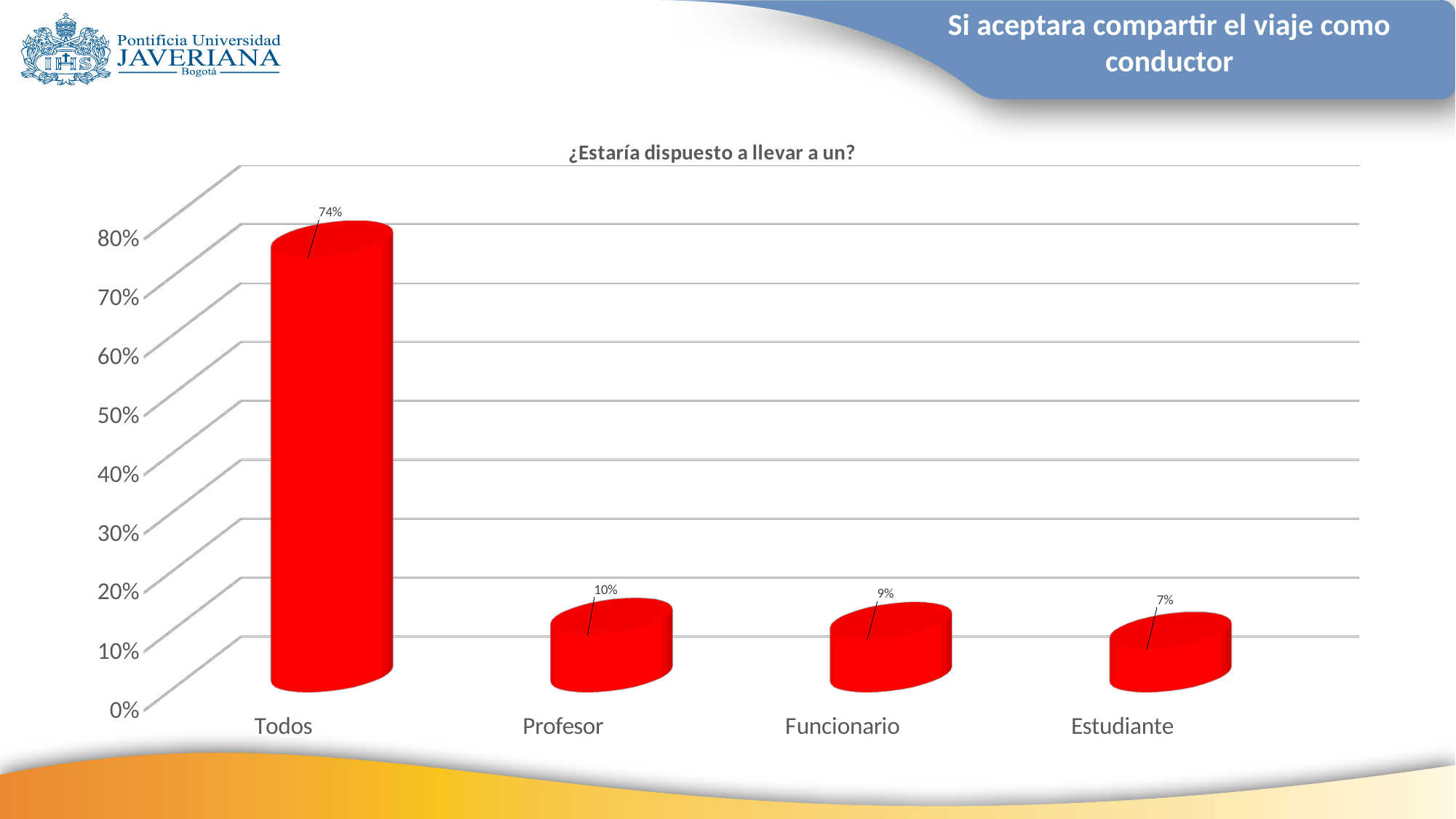
What is the value for Profesor? 10% What is the value for Funcionario? 9% Which category has the lowest value? Estudiante How many categories are shown on the x axis? 4 What is the value for Estudiante? 7% What is the value for Todos? 74% Which category has the highest value? Todos What is the difference between the values for Todos and Profesor? 64% What kind of chart is shown on the slide? bar chart What is the difference between the values for Profesor and Estudiante? 3% Is the value for Todos greater or less than 70%? greater Which is larger, the value for Todos or the value for Funcionario? Todos